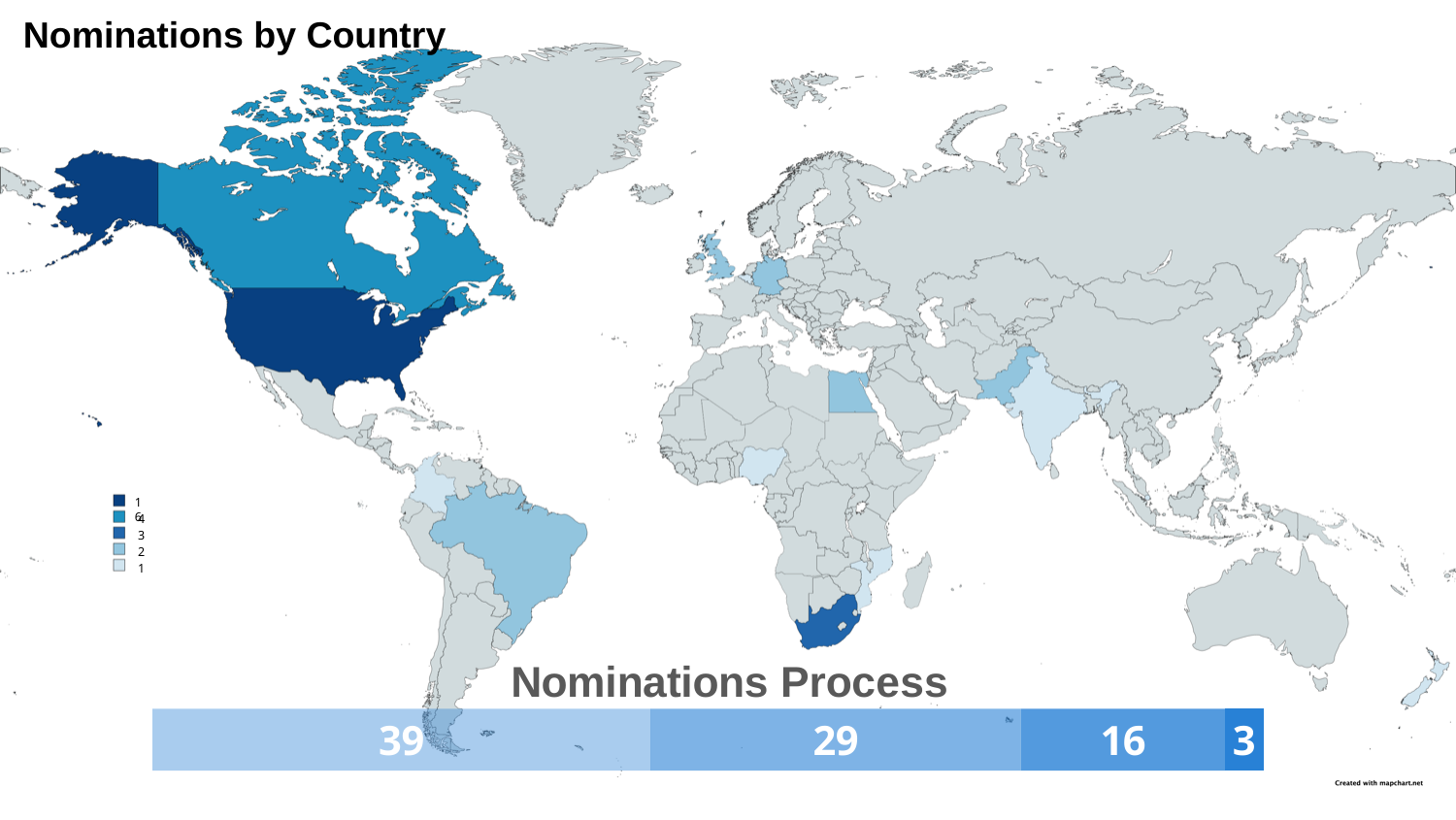
In the "Nominations Process" bar, what is the value of the second segment from the left? 29 How many segments does the "Nominations Process" bar have? 4 What is the largest segment value in the "Nominations Process" bar? 39 What kind of chart is the "Nominations Process" chart at the bottom of the slide? bar chart What is the smallest segment value in the "Nominations Process" bar? 3 What is the total of all segments in the "Nominations Process" bar? 87 In the "Nominations Process" bar, what is the difference between the third segment (16) and the fourth segment (3)? 13 In the "Nominations Process" bar, what is the difference between the first segment (39) and the second segment (29)? 10 In the "Nominations Process" bar, what is the value of the rightmost segment? 3 What is the title of the map chart at the top of the slide? Nominations by Country In the "Nominations Process" bar, which is larger: the second segment or the third segment? the second segment (29) In the "Nominations Process" bar, what is the value of the leftmost segment? 39